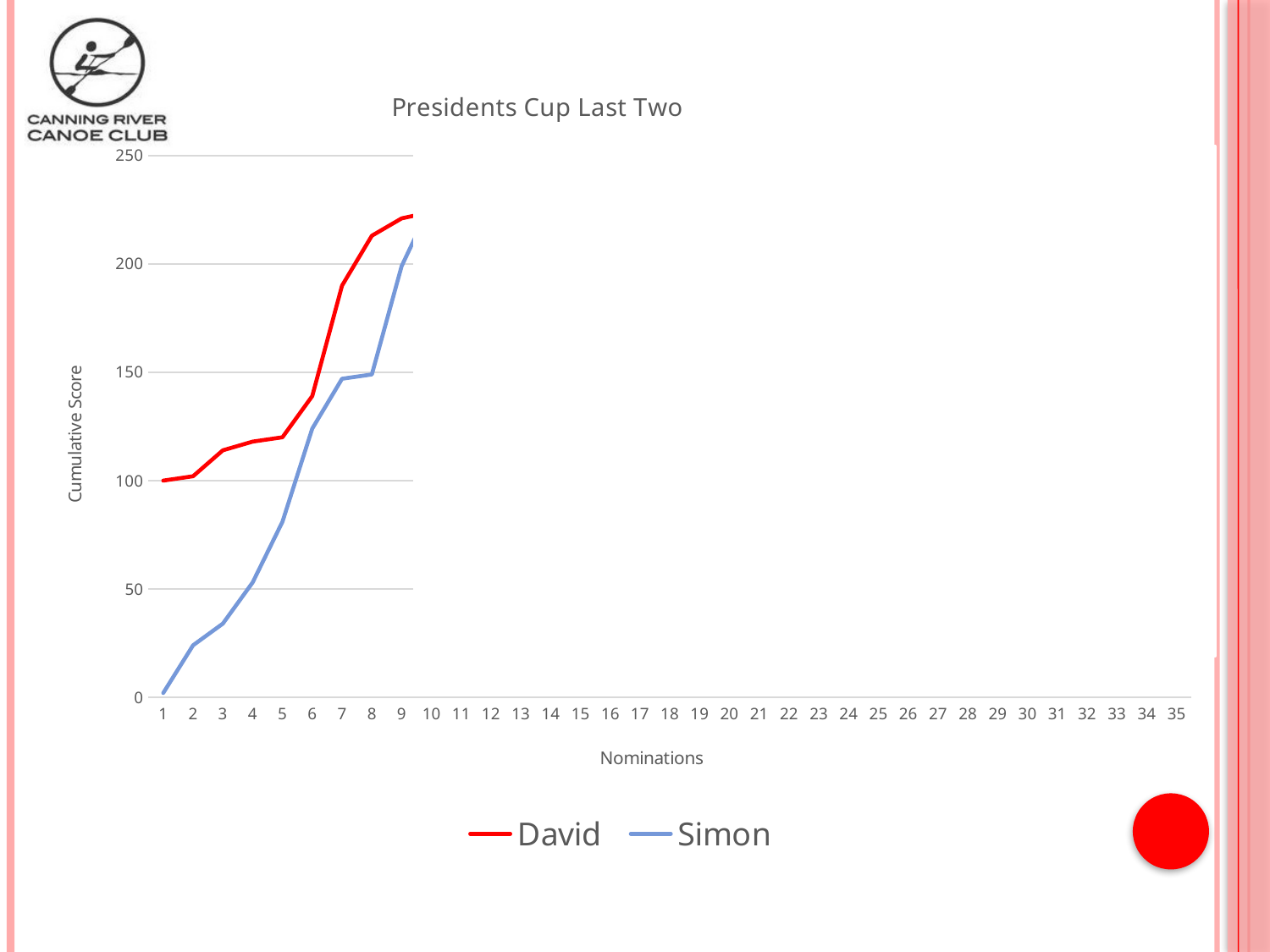
Do Simon's cumulative scores rise or fall as the nominations increase? rise Is Simon's value at nomination 5 greater or less than 100? less What kind of chart is shown on the slide? line chart Is Simon's value at nomination 3 greater or less than 50? less What is the title of the chart? Presidents Cup Last Two What is the label on the y axis? Cumulative Score How many series does the legend list? 2 What is David's cumulative score at nomination 1? 100 Is David's value at nomination 9 greater or less than 200? greater At nomination 5, who has the higher cumulative score, David or Simon? David